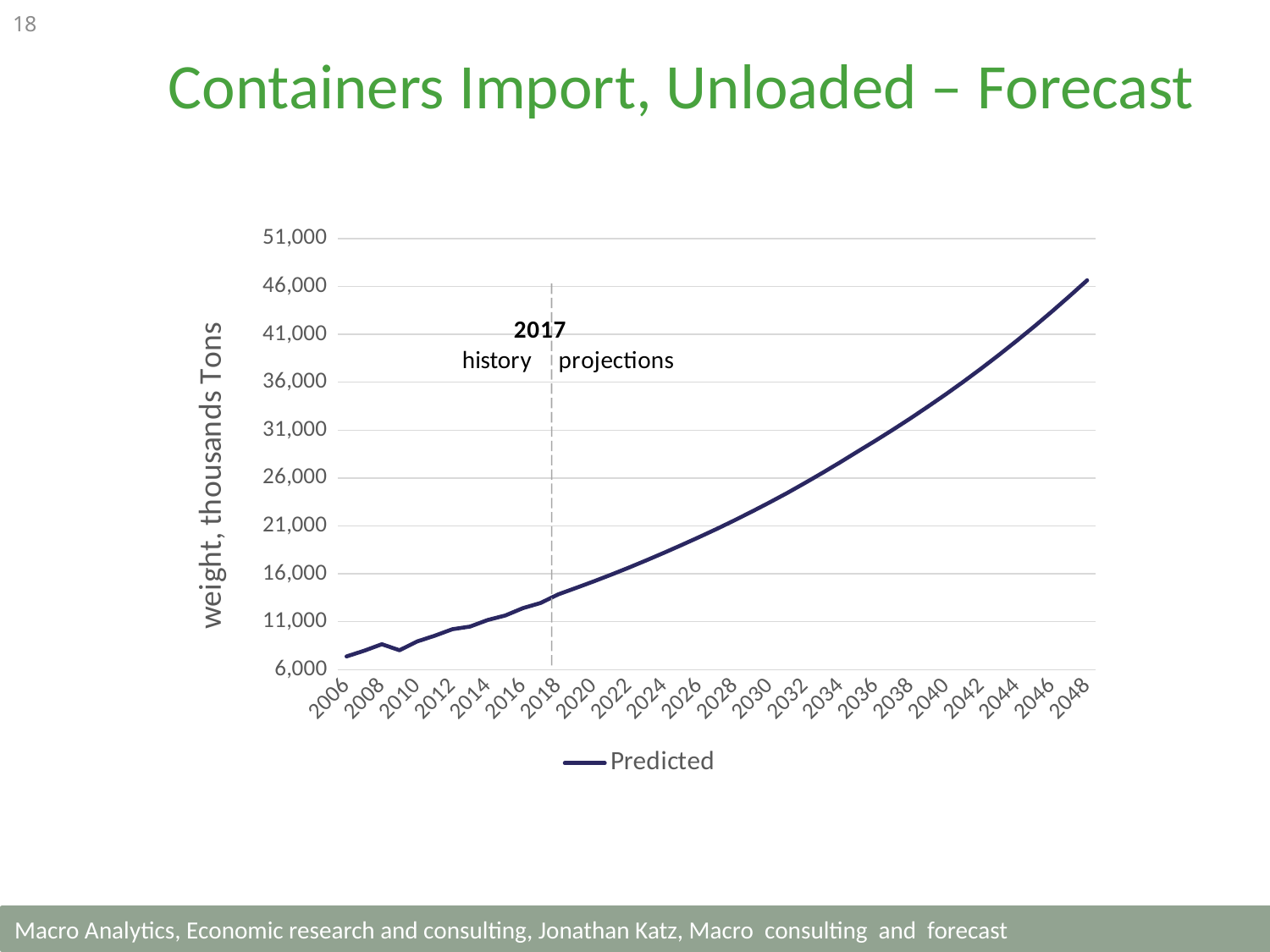
How many series does the legend list? 1 What kind of chart is shown on the slide? line chart What is the label of the vertical axis? weight, thousands Tons Which year has the larger value, 2024 or 2036? 2036 Is the value for 2006 greater or less than 11,000? less What is the name of the series shown in the legend? Predicted Is the value for 2030 greater or less than 21,000? greater Is the value for 2048 greater or less than 41,000? greater Which year has the highest value on the chart? 2048 Do the values generally rise or fall from 2006 to 2048? rise